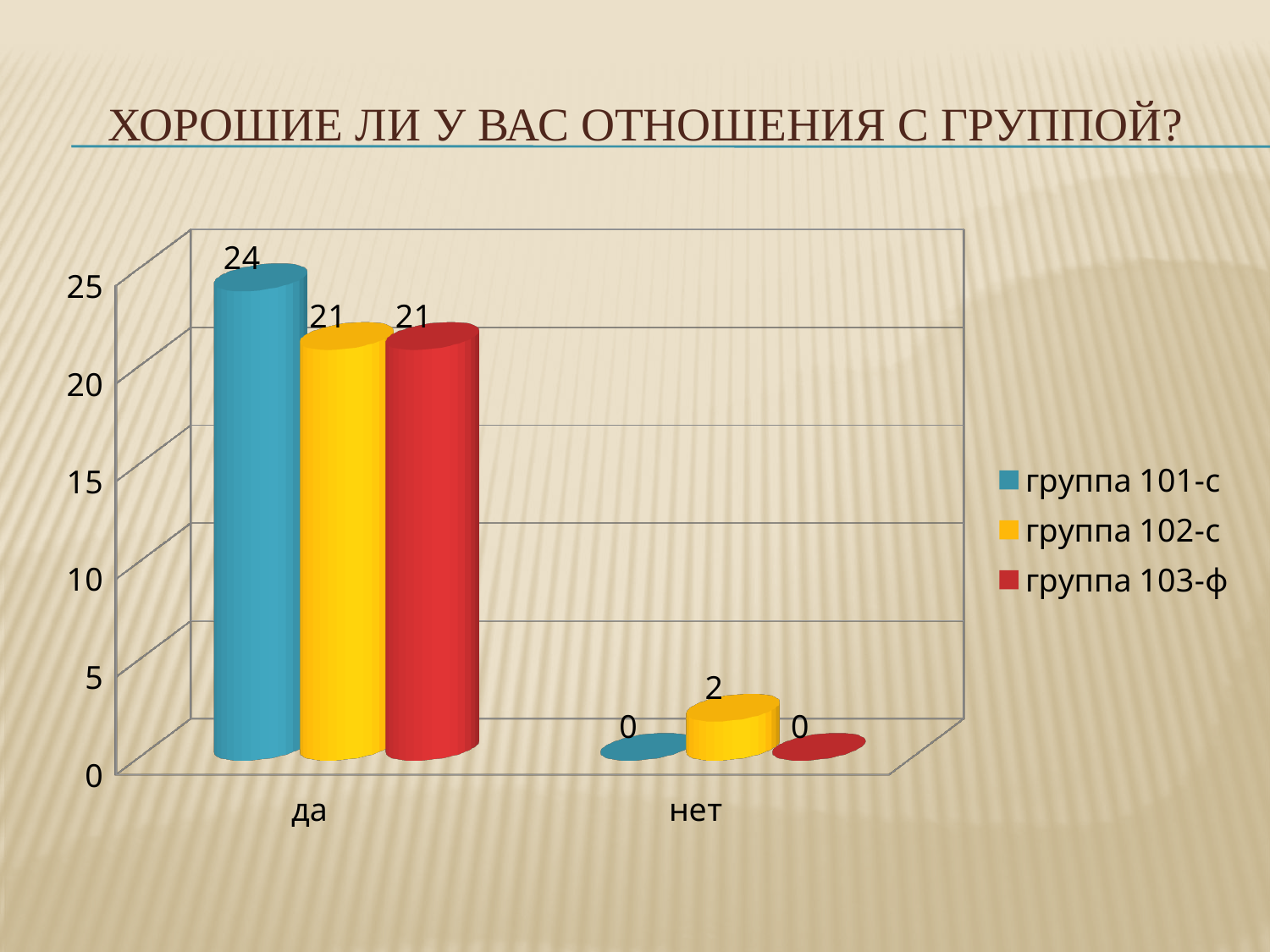
How many categories are shown on the x axis? 2 Which is larger: the да value for группа 101-с or the да value for группа 103-ф? группа 101-с What kind of chart is shown on the slide? bar chart What is the value for группа 101-с in the да category? 24 What is the difference between the да values for группа 101-с and группа 102-с? 3 What is the value for группа 101-с in the нет category? 0 What is the title of the slide? ХОРОШИЕ ЛИ У ВАС ОТНОШЕНИЯ С ГРУППОЙ? What is the value for группа 102-с in the нет category? 2 Which series has the highest value in the да category? группа 101-с What is the value for группа 103-ф in the да category? 21 Which series has the highest value in the нет category? группа 102-с How many series does the legend list? 3